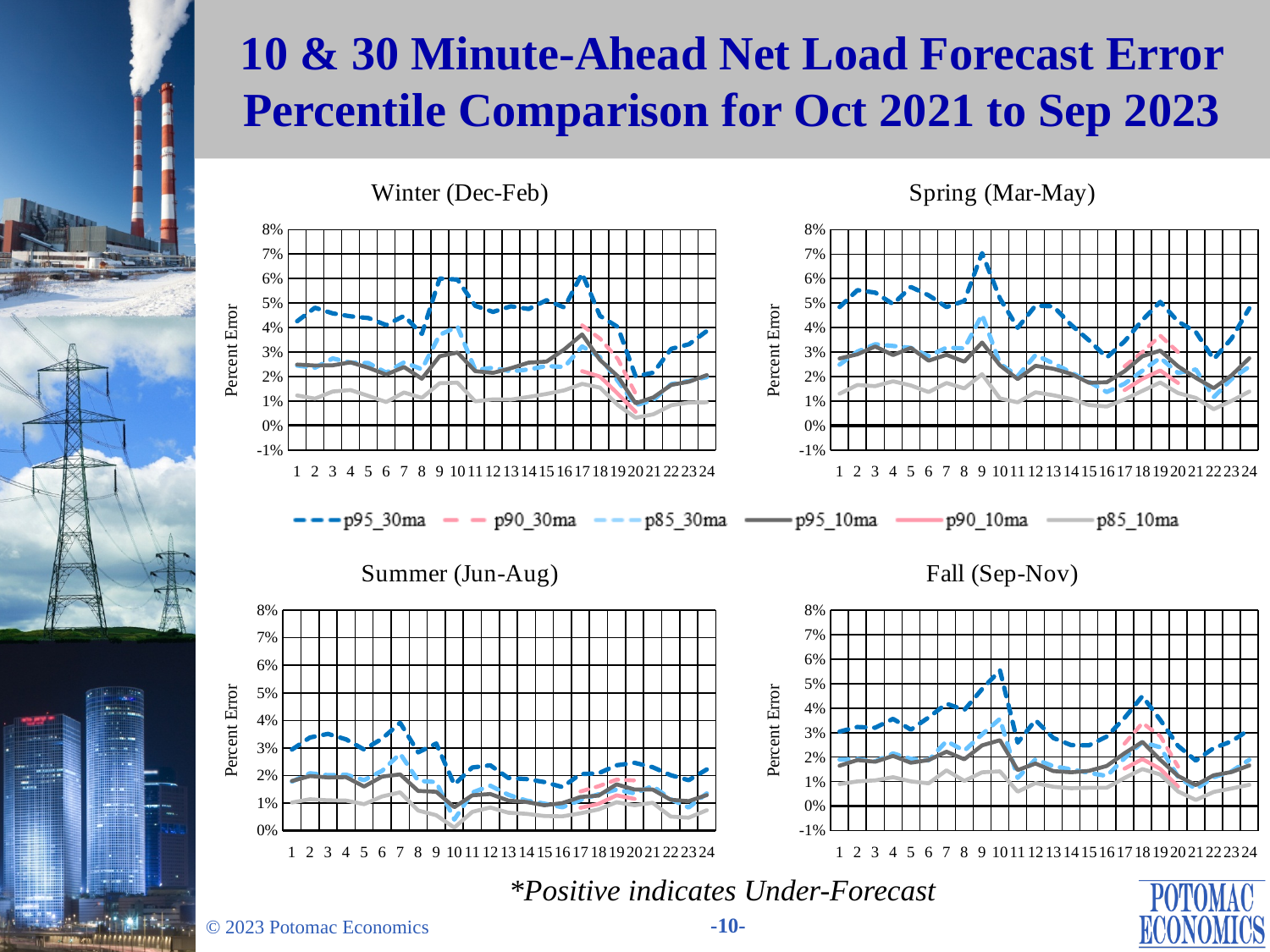
How many series does the shared legend list? 6 In the Winter (Dec-Feb) chart, is the p95_30ma value at hour 17 greater or less than 5%? greater In the Winter (Dec-Feb) chart, is the p85_10ma value at hour 20 greater or less than 1%? less In the Fall (Sep-Nov) chart, is the p95_30ma value at hour 10 greater or less than 5%? greater What is the y-axis label on the Summer (Jun-Aug) chart? Percent Error How many hourly points are plotted along the x axis of the Spring (Mar-May) chart? 24 In the Spring (Mar-May) chart, at which hour does the p95_30ma series reach its highest value? 9 In the Winter (Dec-Feb) chart at hour 9, which is larger: p95_30ma or p95_10ma? p95_30ma In the Fall (Sep-Nov) chart, at which hour does the p95_30ma series reach its highest value? 10 What kind of chart is the Winter (Dec-Feb) chart? line chart